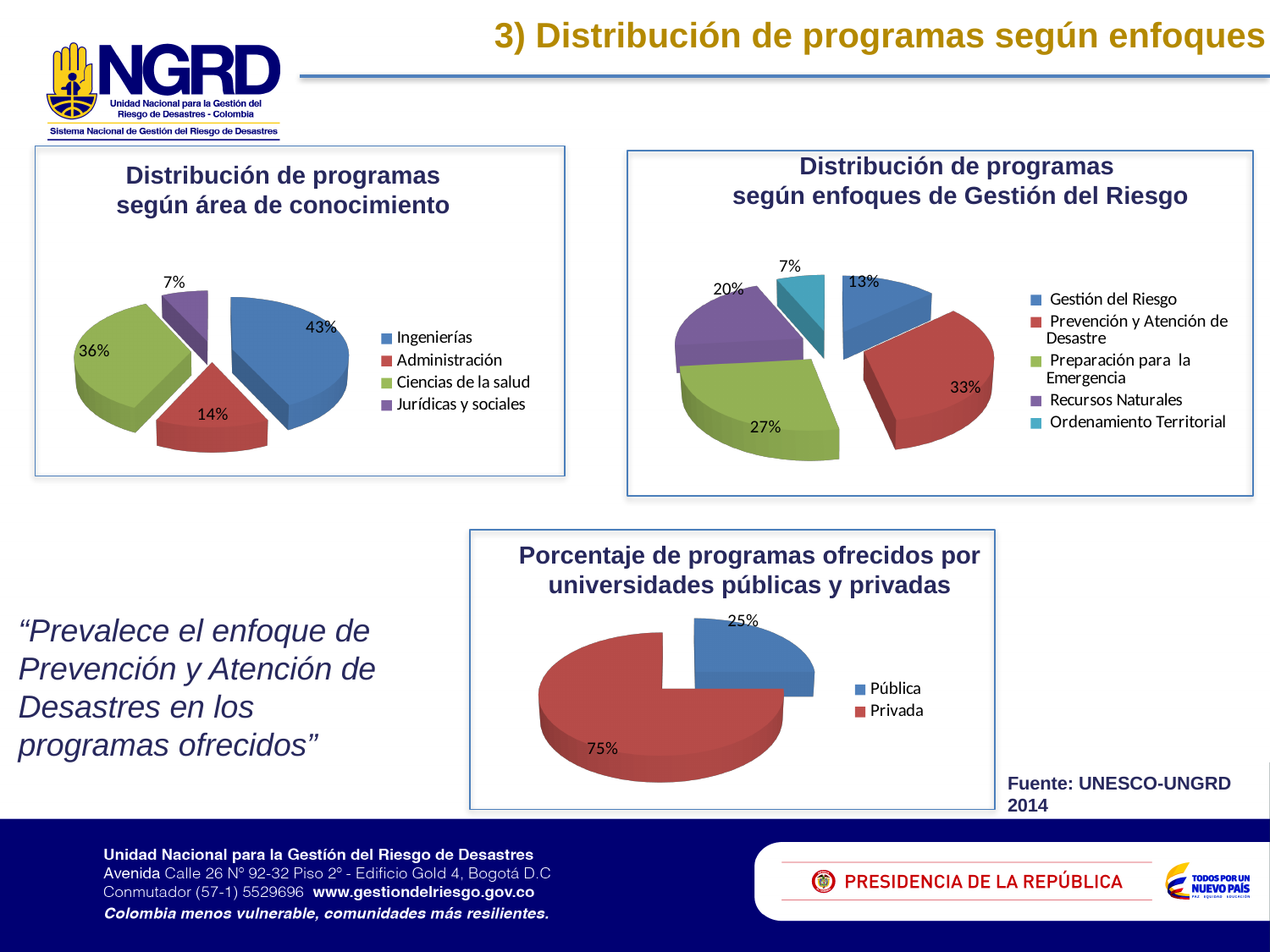
In the chart 'Porcentaje de programas ofrecidos por universidades públicas y privadas', what share is Privada? 75% In the chart 'Distribución de programas según enfoques de Gestión del Riesgo', what share is Prevención y Atención de Desastre? 33% In the chart 'Porcentaje de programas ofrecidos por universidades públicas y privadas', what is the difference between Privada and Pública? 50% In the chart 'Distribución de programas según área de conocimiento', how many categories does the legend list? 4 In the chart 'Distribución de programas según área de conocimiento', what share of programs is Ingenierías? 43% What type of chart is 'Porcentaje de programas ofrecidos por universidades públicas y privadas'? Pie chart In the chart 'Distribución de programas según enfoques de Gestión del Riesgo', which is larger: Recursos Naturales or Gestión del Riesgo? Recursos Naturales In the chart 'Distribución de programas según área de conocimiento', which area has the smallest share? Jurídicas y sociales In the chart 'Distribución de programas según área de conocimiento', what is the difference between the shares of Ingenierías and Ciencias de la salud? 7% In the chart 'Distribución de programas según enfoques de Gestión del Riesgo', how many categories does the legend list? 5 In the chart 'Distribución de programas según enfoques de Gestión del Riesgo', what share is Ordenamiento Territorial? 7% In the chart 'Distribución de programas según enfoques de Gestión del Riesgo', which category has the largest share? Prevención y Atención de Desastre